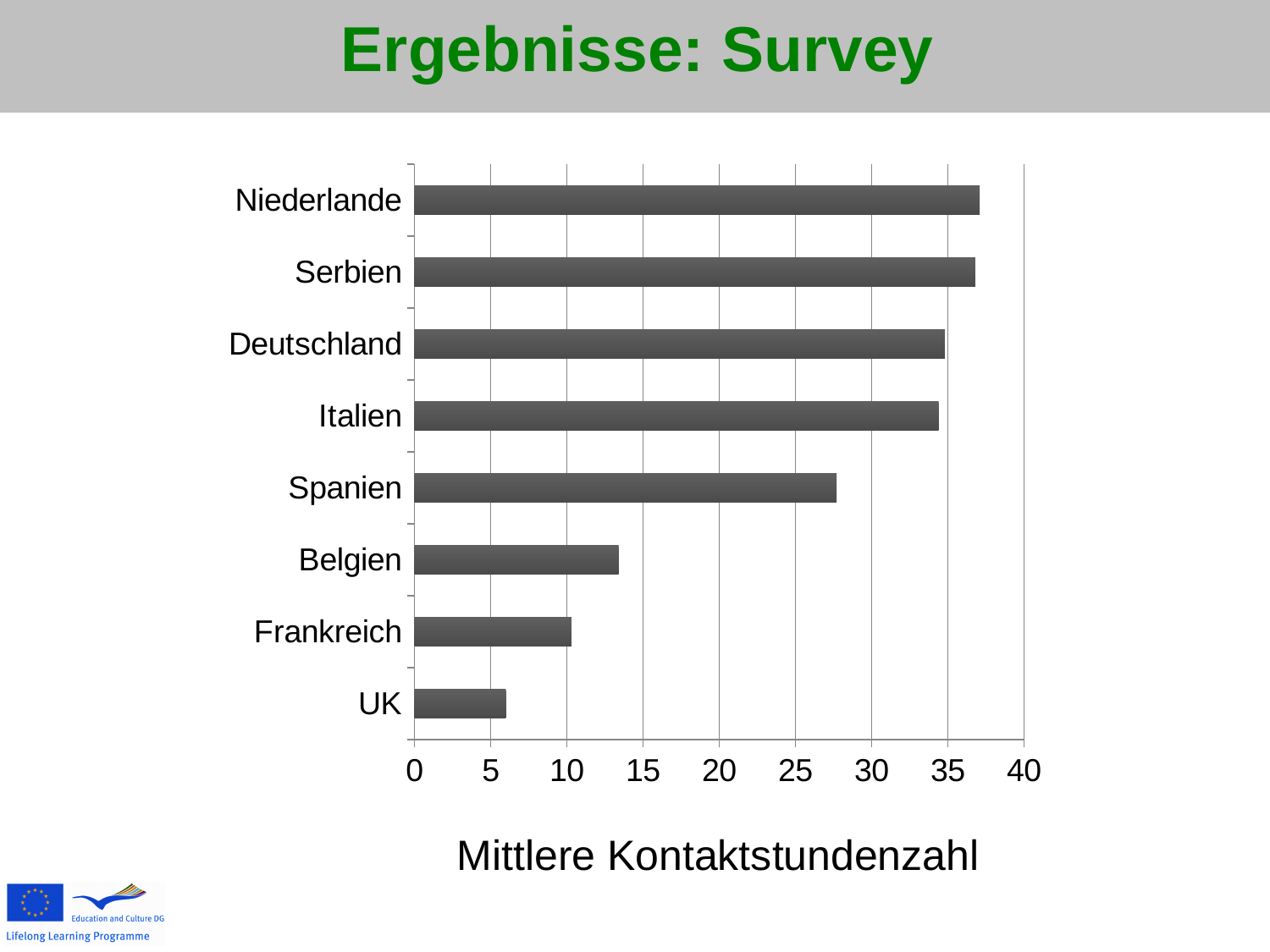
Is the value for Belgien greater or less than 15? less Do the bar values increase or decrease going from the top country (Niederlande) to the bottom country (UK)? decrease How many countries are shown in the chart? 8 Which country has the lowest mean contact hours (Mittlere Kontaktstundenzahl)? UK Is the value for Spanien greater or less than 25? greater Which has the larger value, Spanien or Belgien? Spanien Is the value for UK greater or less than 10? less What kind of chart is shown on the slide? bar chart What is the label shown on the horizontal axis of the chart? Mittlere Kontaktstundenzahl Which has the larger value, Deutschland or Spanien? Deutschland